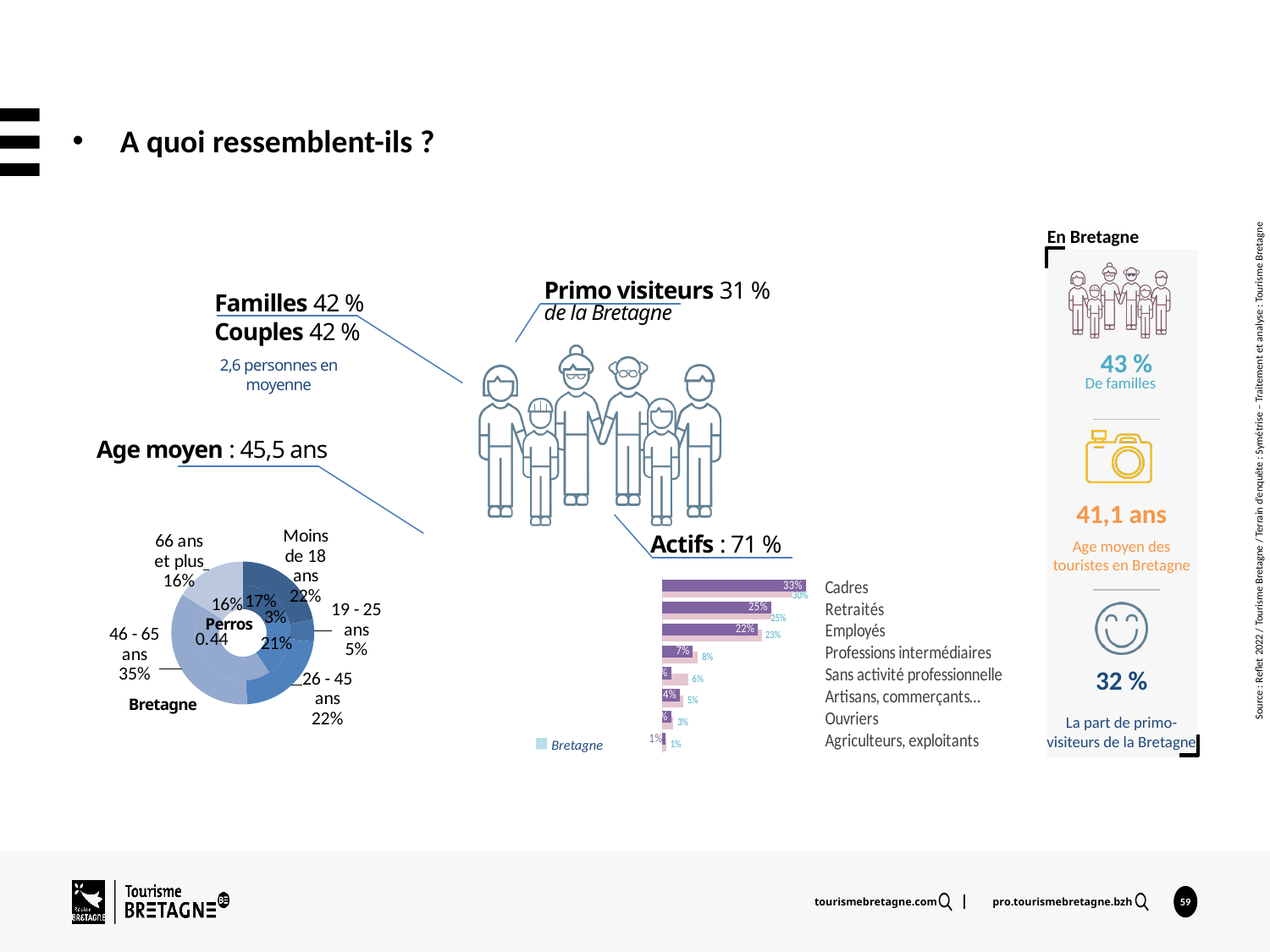
In the professions bar chart, what is the value of the lower (pink) bar for Employés? 23% In the professions bar chart, how many profession categories are listed? 8 In the age doughnut chart, which age category has the smallest outer-ring share? 19 - 25 ans In the professions bar chart, which category has the lowest value? Agriculteurs, exploitants In the professions bar chart, which category has the highest value? Cadres In the professions bar chart, what is the difference between the purple bar for Cadres (33%) and the purple bar for Retraités (25%)? 8 percentage points What kind of chart is the age-distribution chart on the left (Moins de 18 ans, 19 - 25 ans...)? doughnut chart What kind of chart is the chart listing professions (Cadres, Retraités, Employés...)? bar chart In the age doughnut chart, which outer-ring share is larger: Moins de 18 ans or 19 - 25 ans? Moins de 18 ans In the professions bar chart, what is the value of the top (purple) bar for Cadres? 33% In the age doughnut chart, how many age categories are there? 5 In the age doughnut chart, what is the outer-ring value for 46 - 65 ans? 35%